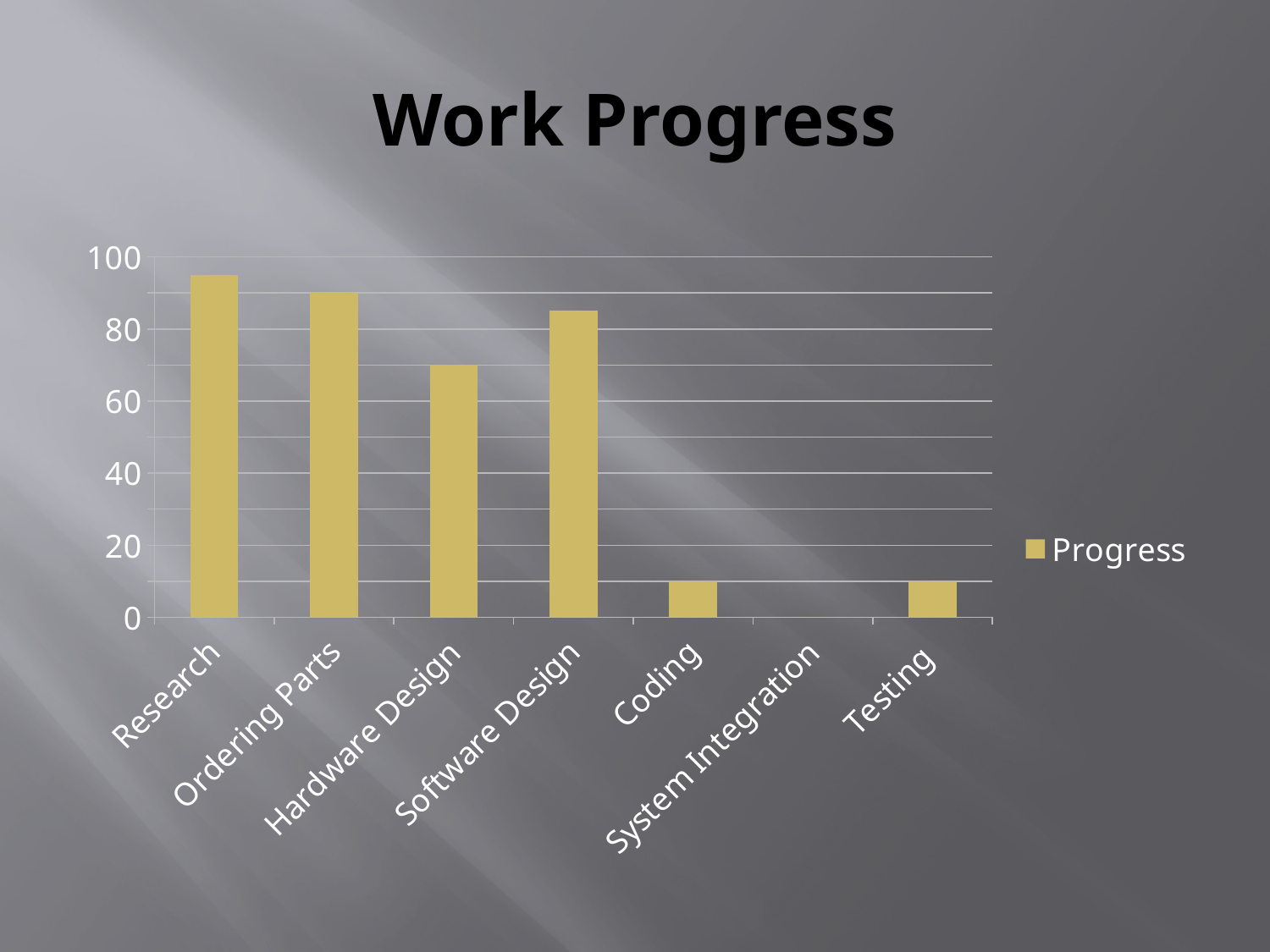
What kind of chart is shown on the slide? bar chart Is the Progress value for Research greater or less than 80? greater Which has a higher Progress value, Software Design or Hardware Design? Software Design Which category has the lowest Progress value? System Integration Is the Progress value for Coding greater or less than 20? less What is the name of the series shown in the legend? Progress What is the Progress value for System Integration? 0 How many categories are shown on the x axis of the chart? 7 How many series does the legend list? 1 Is the Progress value for Hardware Design greater or less than 80? less What is the title of the chart? Work Progress Which category has the highest Progress value? Research